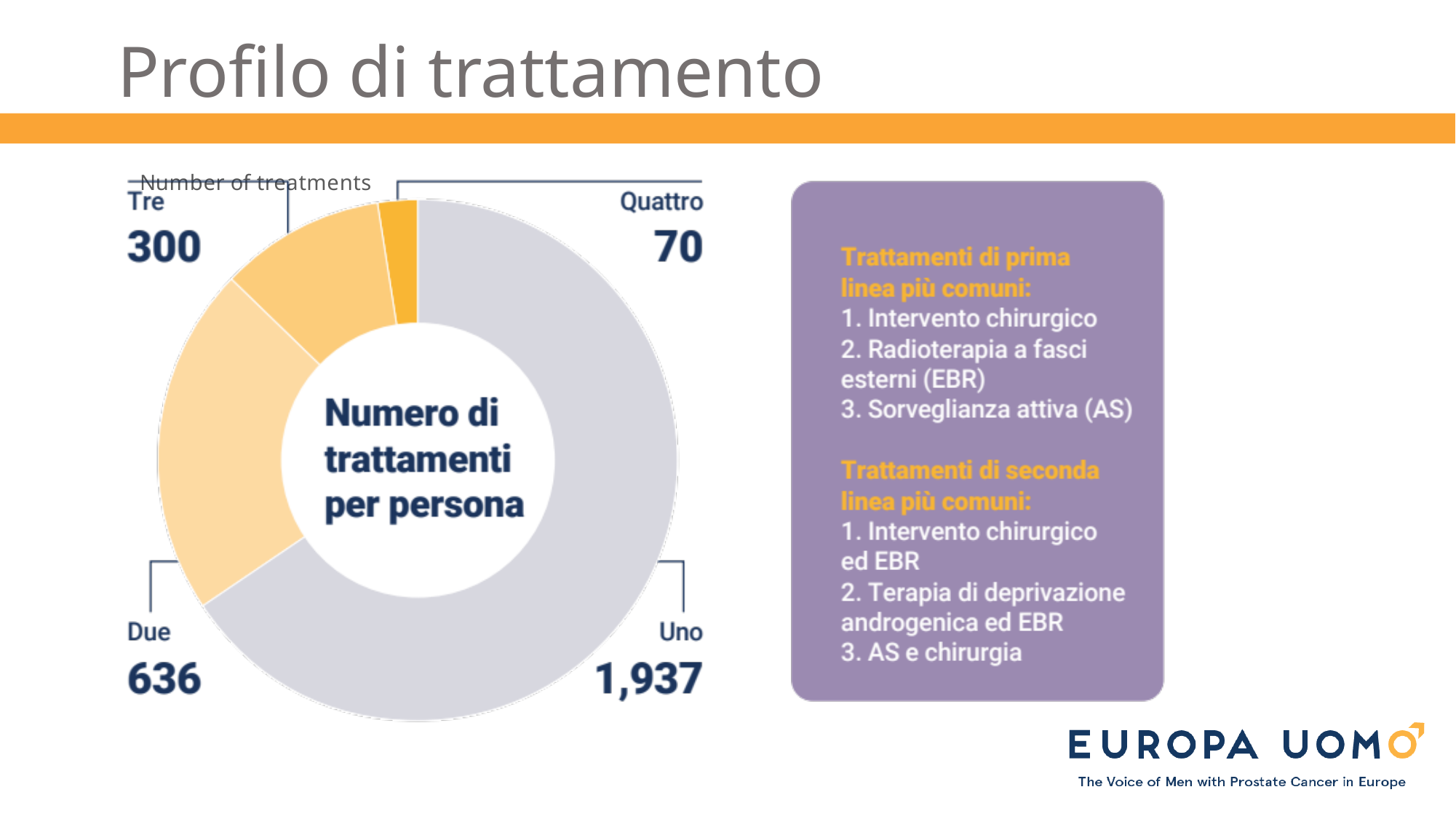
What is the difference between the values for 'Tre' and 'Quattro'? 230 What is the difference between the values for 'Uno' and 'Due'? 1,301 What is the value for the 'Tre' category in the chart? 300 What kind of chart is shown on the slide? Donut (pie) chart Which is larger, the value for 'Due' or the value for 'Tre'? Due What text is written in the centre of the donut chart? Numero di trattamenti per persona How many categories does the chart show? 4 What is the value for the 'Uno' category in the chart? 1,937 Which category has the largest value in the chart? Uno What is the value for the 'Quattro' category in the chart? 70 What is the value for the 'Due' category in the chart? 636 Which category has the smallest value in the chart? Quattro